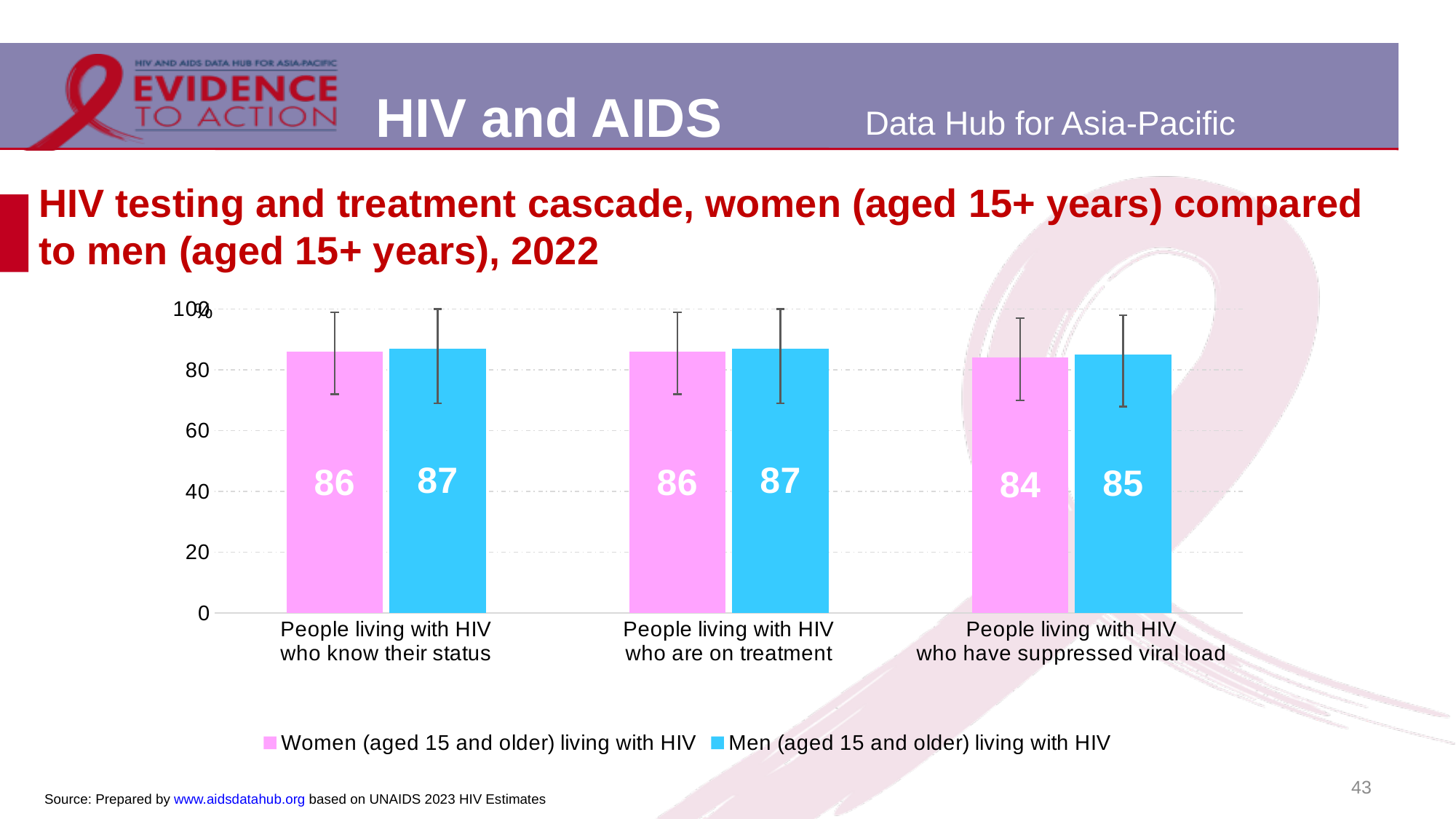
Which colour represents women (aged 15 and older) living with HIV? Pink Do the values for men living with HIV rise or fall from the first category to the last? Fall What kind of chart is shown on the slide? Bar chart What is the difference between the women value for people who know their status and the women value for people who have suppressed viral load? 2 What is the value for women living with HIV who know their status? 86 Which category has the lowest value for women living with HIV? People living with HIV who have suppressed viral load What is the value for men living with HIV who have suppressed viral load? 85 What is the value for women living with HIV who have suppressed viral load? 84 What is the value for men living with HIV who are on treatment? 87 What is the difference between the men and women values for people living with HIV who know their status? 1 How many categories are shown on the x axis? 3 How many series does the legend list? 2